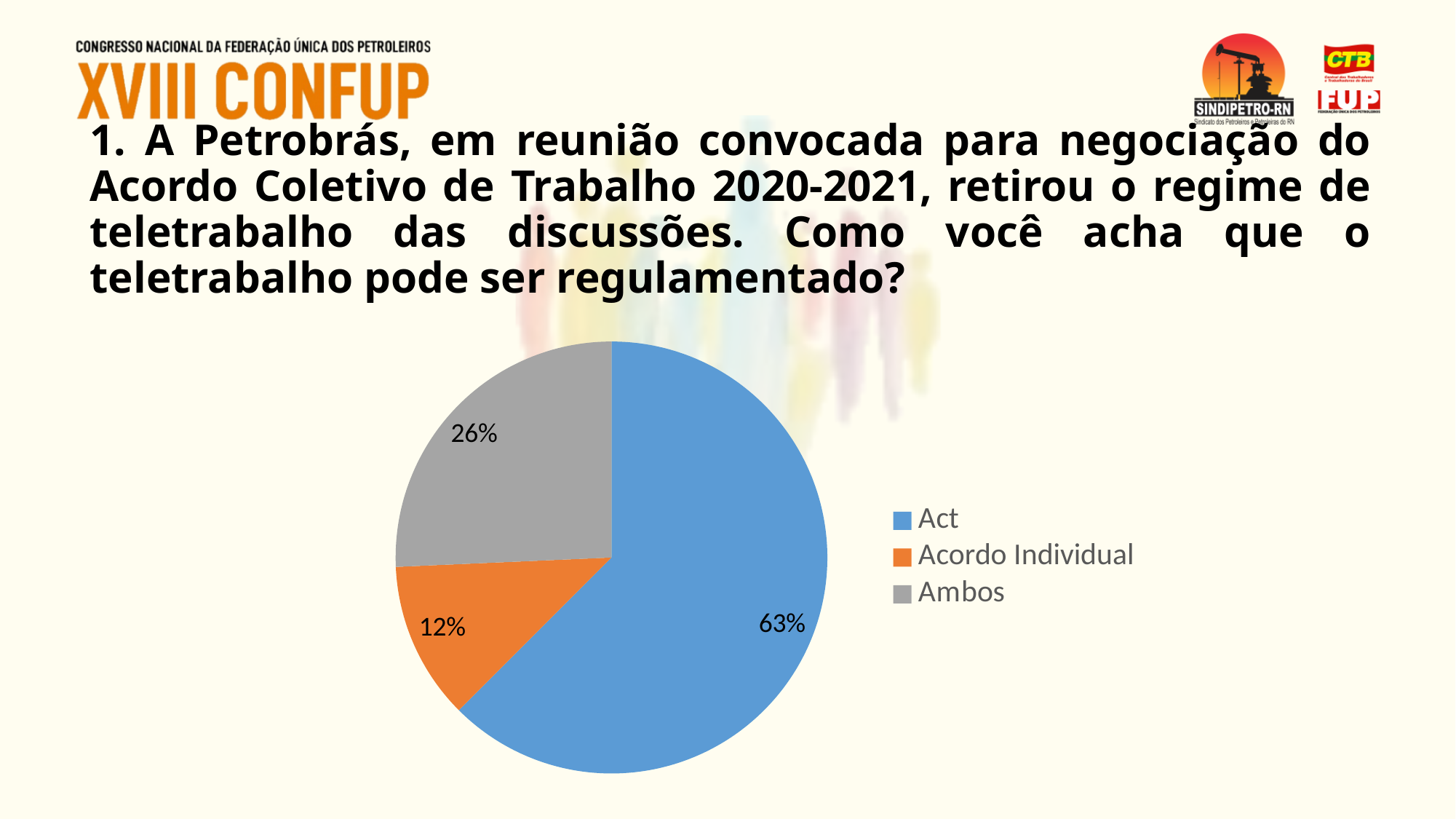
What kind of chart is shown on the slide? Pie chart Which legend entry is shown in grey? Ambos What share of the pie does Acordo Individual represent? 12% Which is larger, the share for Ambos or the share for Acordo Individual? Ambos What is the difference in percentage points between Act and Ambos? 37 What colour is the slice for Acordo Individual? Orange What share of the pie does Ambos represent? 26% Which category has the largest slice of the pie? Act How many categories are shown in the pie chart? 3 What share of the pie does Act represent? 63% What is the difference in percentage points between Ambos and Acordo Individual? 14 Which category has the smallest slice of the pie? Acordo Individual